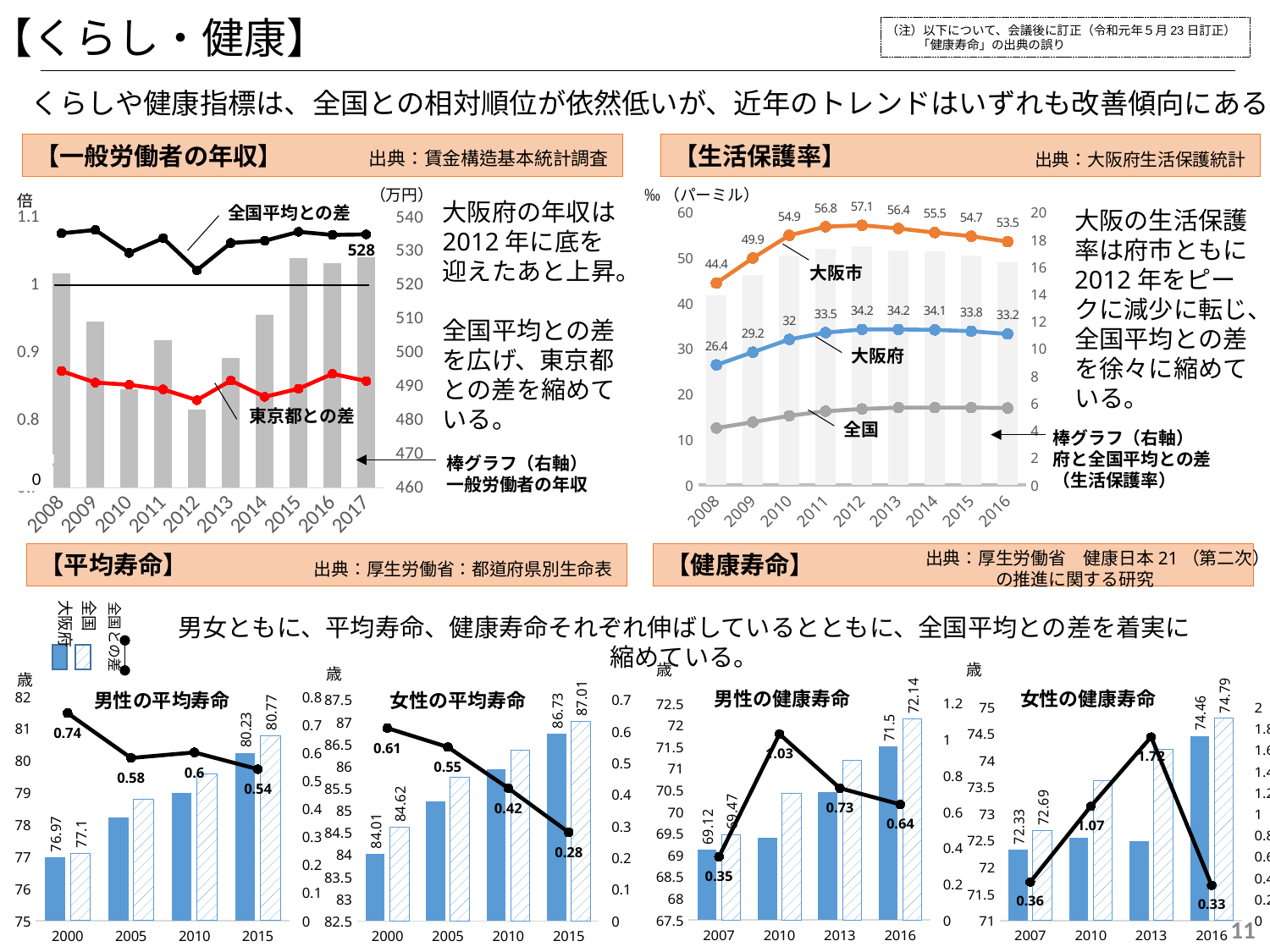
In the 【一般労働者の年収】 chart, is the bar for 2012 greater or less than 490 (万円)? less In the 男性の健康寿命 chart, in which year is the 全国との差 line highest? 2010 In the 【一般労働者の年収】 chart, what is the labelled value of the bar for 2017 (万円)? 528 In the 【生活保護率】 chart, in which year does the 大阪市 line reach its highest value? 2012 In the 【生活保護率】 chart, what is the difference between 大阪市 and 大阪府 in 2016? 20.3 In the 女性の平均寿命 chart, does the 全国との差 line rise or fall from 2000 to 2015? fall In the 【生活保護率】 chart, what is the value for 大阪府 in 2008? 26.4 In the 女性の健康寿命 chart, what is the difference between 全国 and 大阪府 in 2016? 0.33 In the 男性の平均寿命 chart, what is the 全国との差 value for 2000? 0.74 In the 【生活保護率】 chart, what is the value for 大阪市 in 2012? 57.1 In the 男性の平均寿命 chart, what is the value for 大阪府 in 2015? 80.23 In the 【生活保護率】 chart, how many years are shown on the x axis? 9